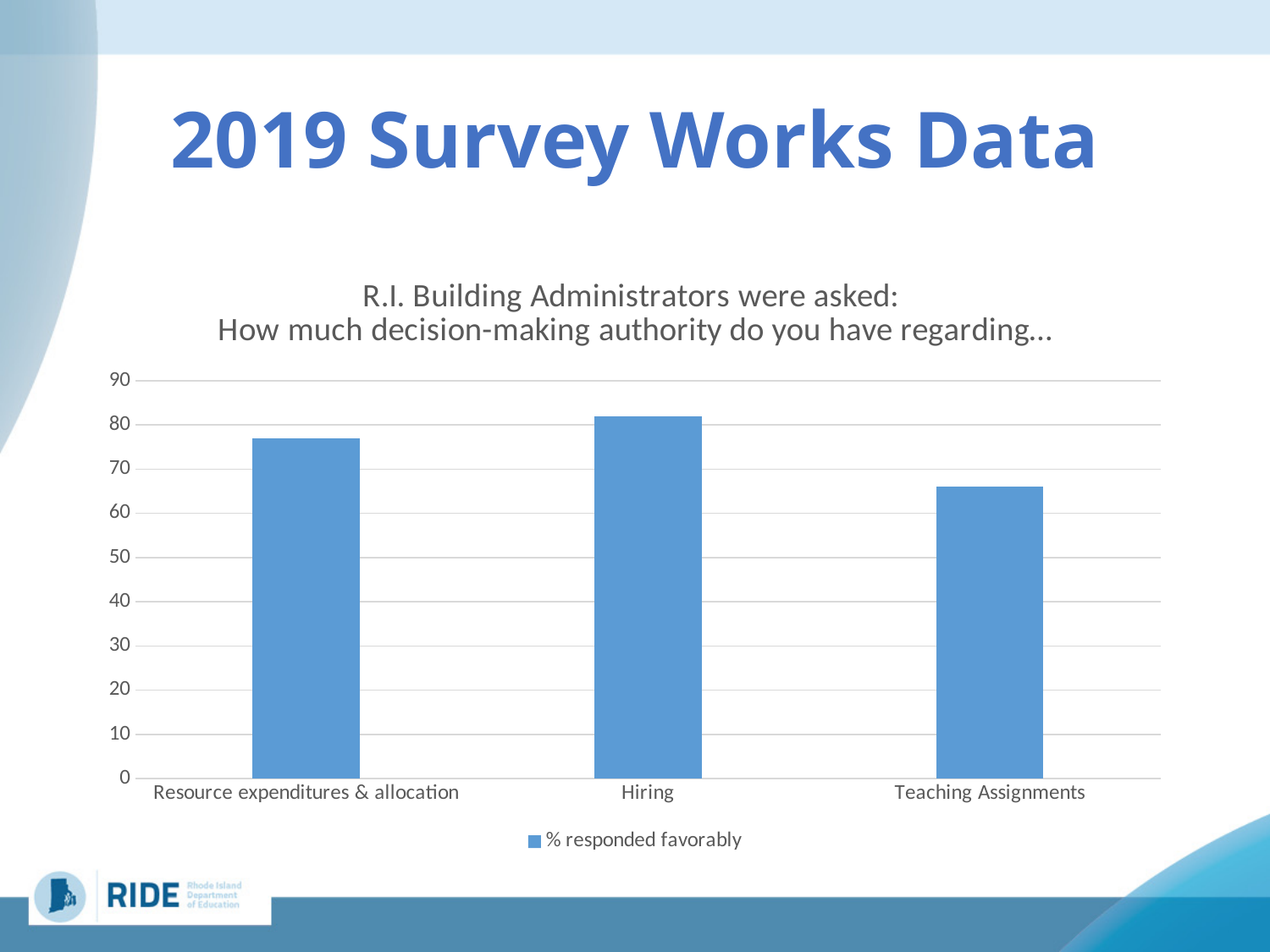
Which category has the highest value in the chart? Hiring What is the name of the series listed in the chart's legend? % responded favorably How many categories are shown on the x axis of the chart? 3 What is the title of the chart? R.I. Building Administrators were asked: How much decision-making authority do you have regarding… Which is larger, the value for Hiring or the value for Teaching Assignments? Hiring What kind of chart is shown on the slide? bar chart How many series does the chart's legend list? 1 Is the value for Teaching Assignments greater or less than 70? less Which is larger, the value for Resource expenditures & allocation or the value for Teaching Assignments? Resource expenditures & allocation Which category has the lowest value in the chart? Teaching Assignments Is the value for Resource expenditures & allocation greater or less than 70? greater